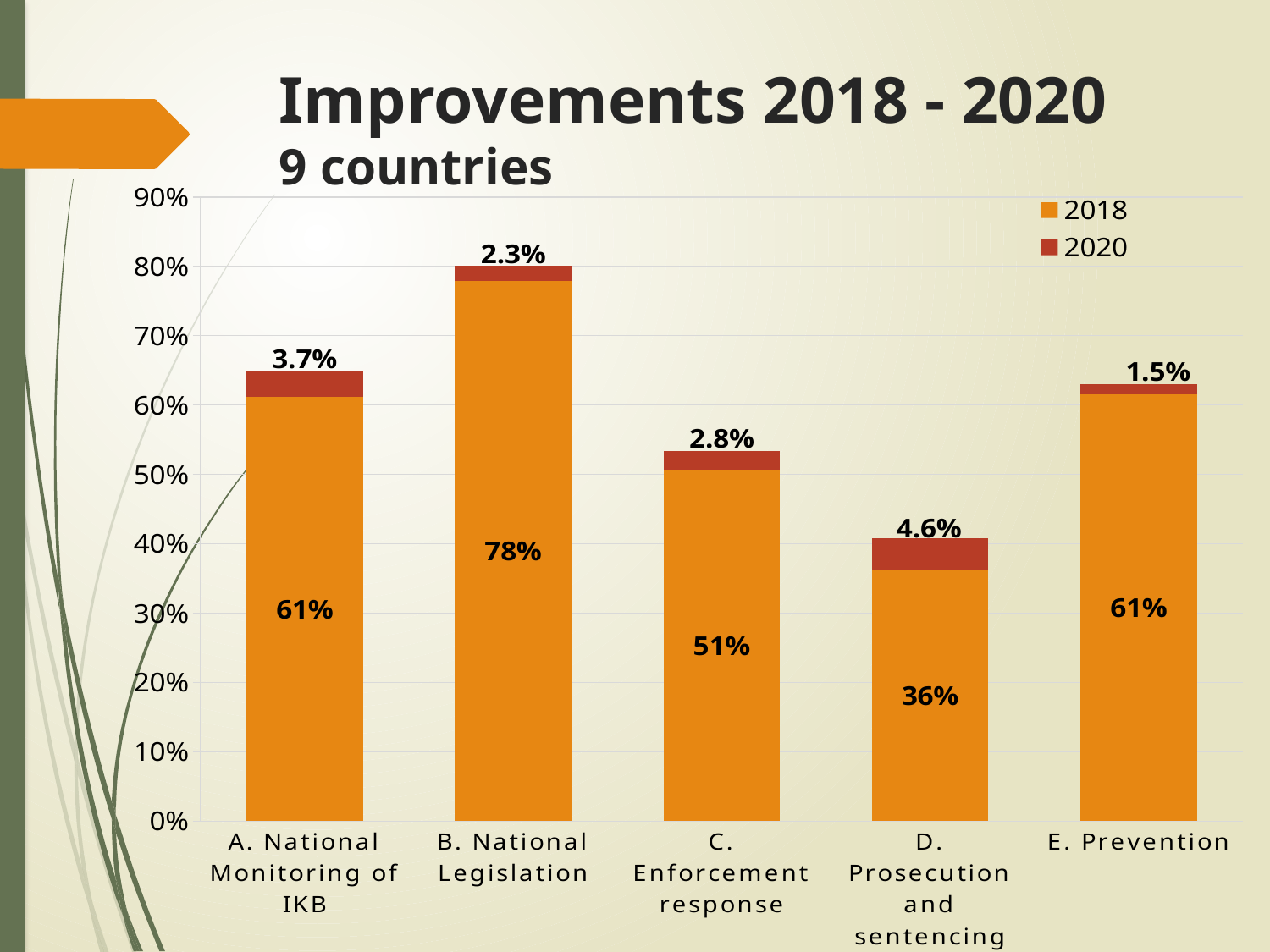
How many series does the legend list? 2 Which category has the lowest 2018 value? D. Prosecution and sentencing Which category has the largest 2020 value? D. Prosecution and sentencing Which is larger, the 2020 value for A. National Monitoring of IKB or the 2020 value for C. Enforcement response? A. National Monitoring of IKB What is the 2020 value for E. Prevention? 1.5% What is the 2018 value for B. National Legislation? 78% What is the total of the stacked bar for D. Prosecution and sentencing? 40.6% What is the difference between the 2018 values for B. National Legislation and C. Enforcement response? 27% What is the 2020 value for D. Prosecution and sentencing? 4.6% What kind of chart is shown on the slide? Stacked bar chart Which category has the highest 2018 value? B. National Legislation How many categories are shown on the x axis? 5